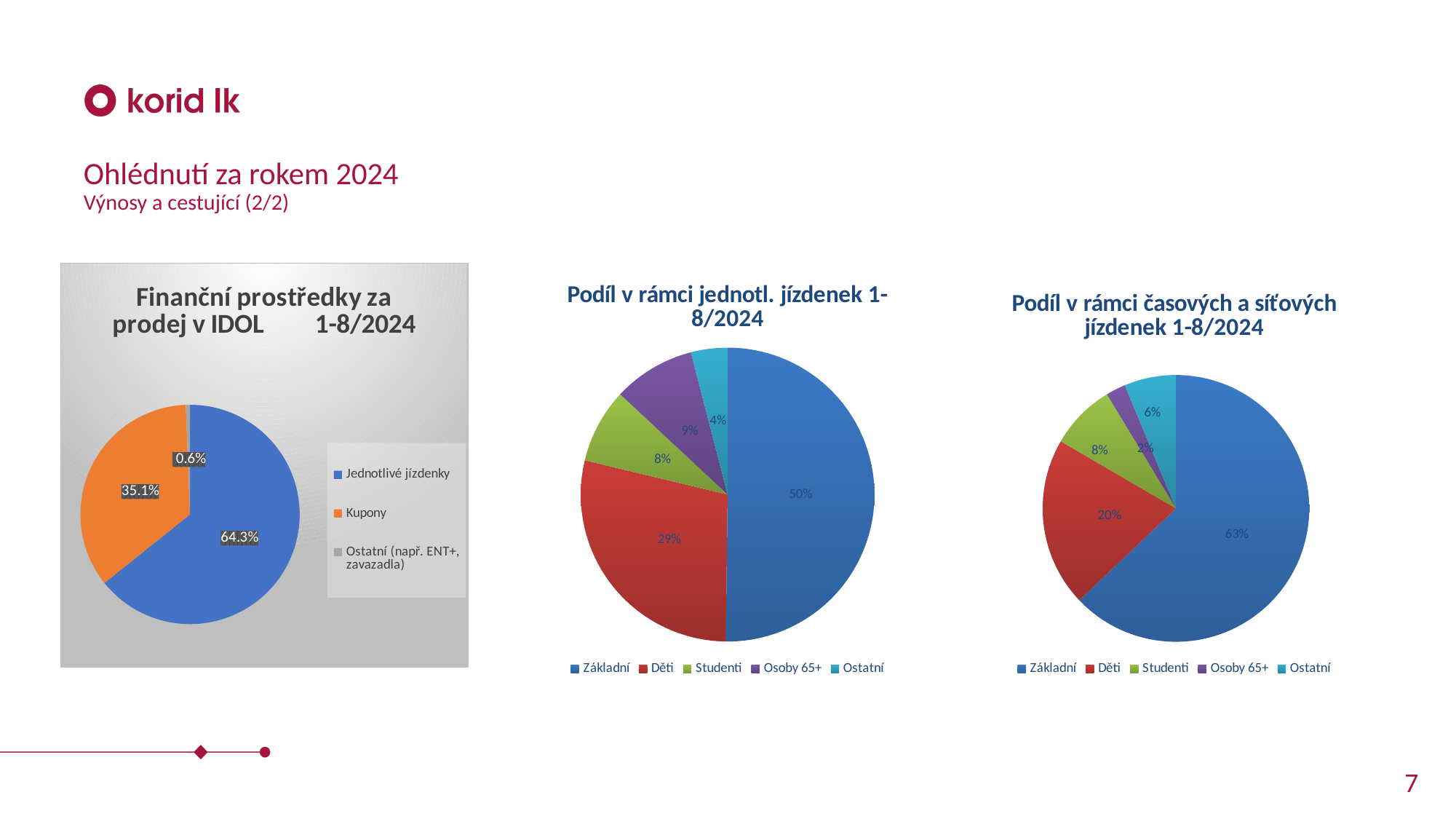
In the chart 'Podíl v rámci časových a síťových jízdenek 1-8/2024', which is larger, the share for Studenti or the share for Ostatní? Studenti How many charts are shown on the slide? 3 In the chart 'Finanční prostředky za prodej v IDOL 1-8/2024', which category has the largest share? Jednotlivé jízdenky In the chart 'Podíl v rámci časových a síťových jízdenek 1-8/2024', what is the share for Osoby 65+? 2% In the chart 'Finanční prostředky za prodej v IDOL 1-8/2024', what is the share for Kupony? 35.1% In the chart 'Podíl v rámci jednotl. jízdenek 1-8/2024', what is the share for Děti? 29% In the chart 'Podíl v rámci časových a síťových jízdenek 1-8/2024', what is the share for Základní? 63% In the chart 'Podíl v rámci časových a síťových jízdenek 1-8/2024', what is the difference between the shares of Základní and Děti? 43% In the chart 'Podíl v rámci jednotl. jízdenek 1-8/2024', how many categories does the legend list? 5 In the chart 'Podíl v rámci jednotl. jízdenek 1-8/2024', which category has the smallest share? Ostatní What kind of chart is 'Podíl v rámci jednotl. jízdenek 1-8/2024'? Pie chart In the chart 'Finanční prostředky za prodej v IDOL 1-8/2024', what is the difference between the shares of Jednotlivé jízdenky and Kupony? 29.2%